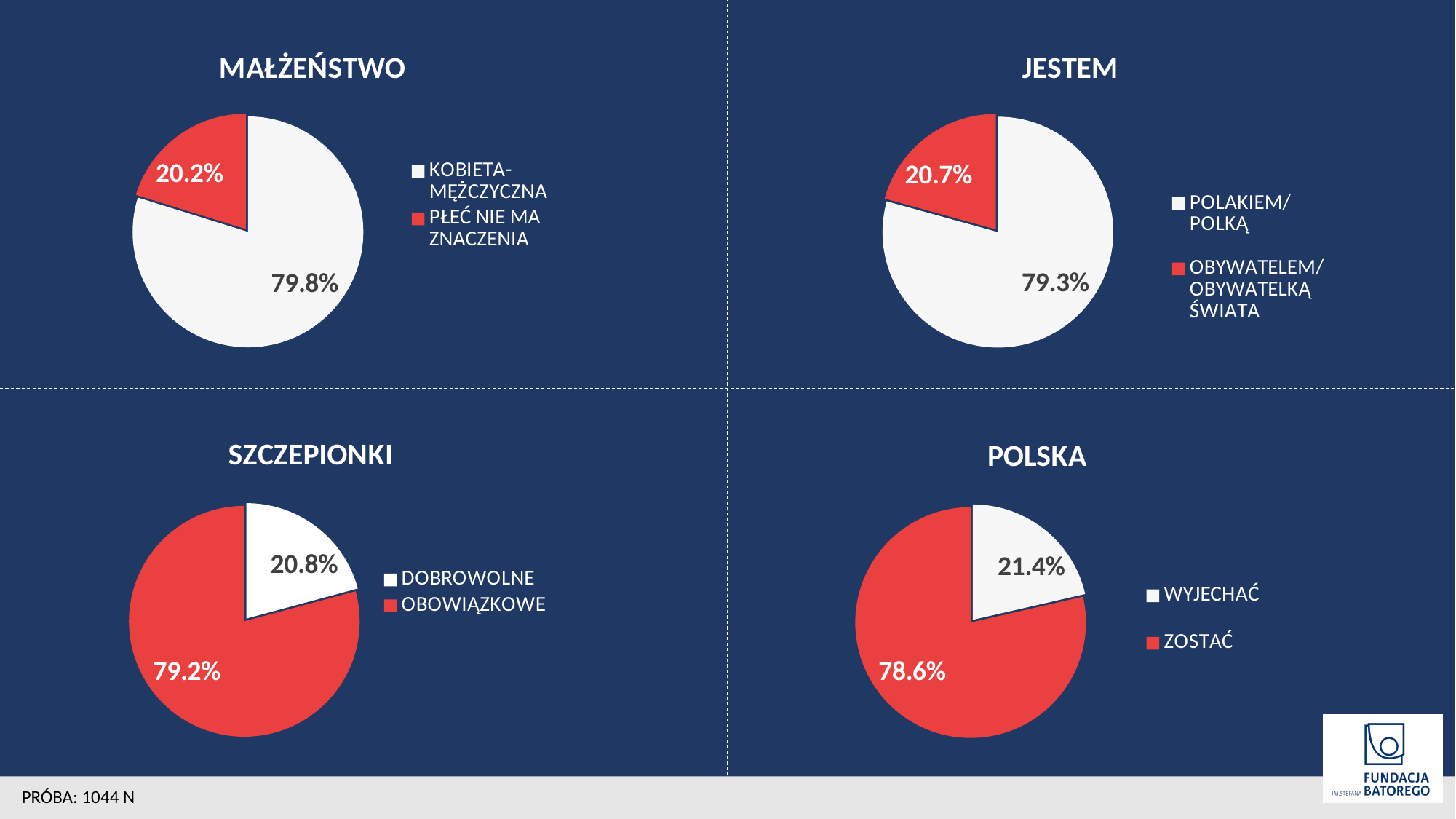
In the MAŁŻEŃSTWO chart, what share is labelled for KOBIETA-MĘŻCZYZNA? 79.8% In the MAŁŻEŃSTWO chart, what share is labelled for PŁEĆ NIE MA ZNACZENIA? 20.2% How many categories does the legend of the JESTEM chart list? 2 In the POLSKA chart, which is larger: WYJECHAĆ or ZOSTAĆ? ZOSTAĆ In the SZCZEPIONKI chart, what share is labelled for OBOWIĄZKOWE? 79.2% In the POLSKA chart, what is the difference between the ZOSTAĆ and WYJECHAĆ shares? 57.2% In the JESTEM chart, what share is labelled for OBYWATELEM/OBYWATELKĄ ŚWIATA? 20.7% In the SZCZEPIONKI chart, which category has the smallest slice? DOBROWOLNE In the MAŁŻEŃSTWO chart, what colour is the PŁEĆ NIE MA ZNACZENIA slice? Red What kind of chart is the SZCZEPIONKI chart? Pie chart In the JESTEM chart, which category has the largest slice? POLAKIEM/POLKĄ In the POLSKA chart, what share is labelled for ZOSTAĆ? 78.6%